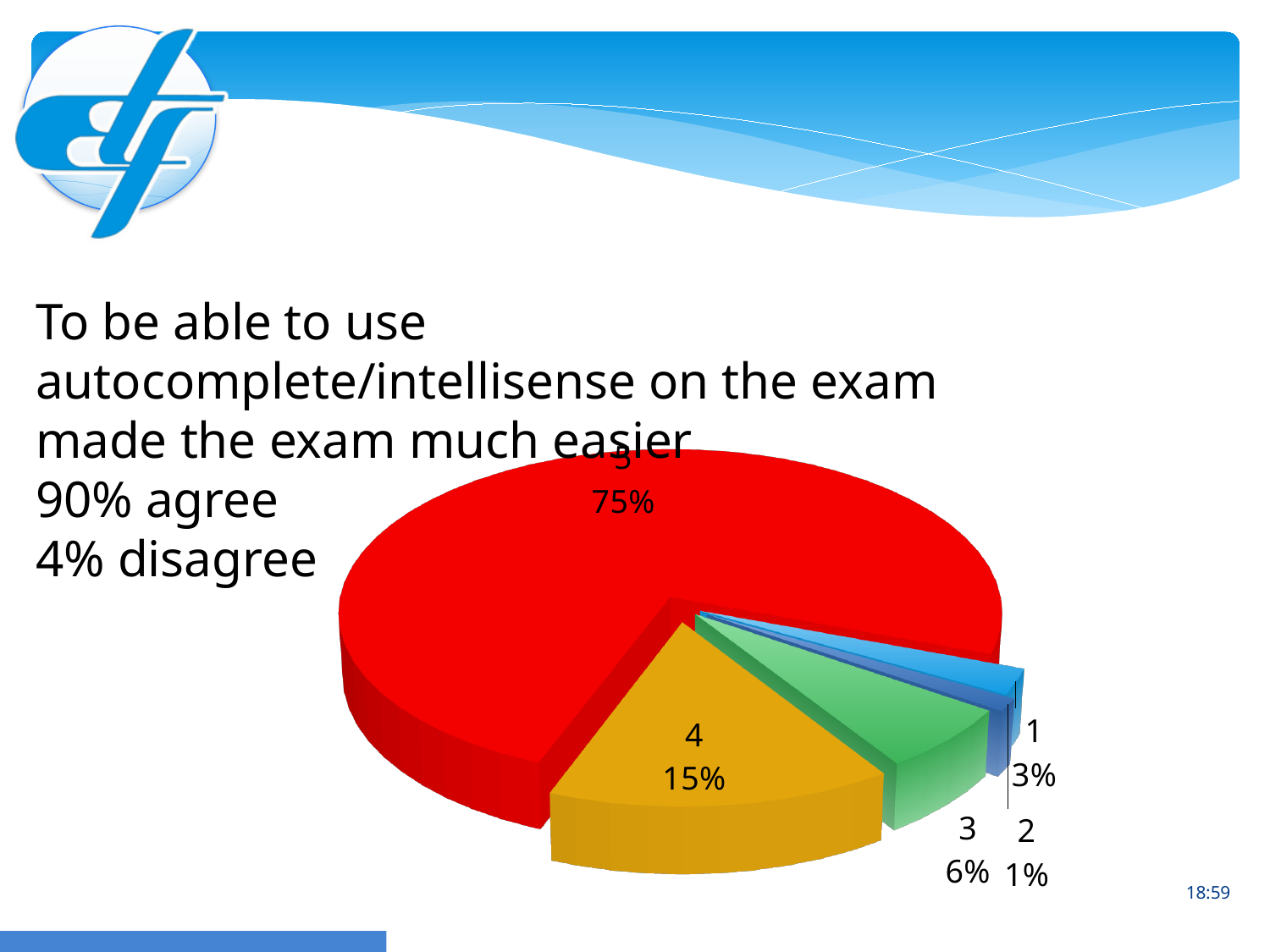
What percentage is shown for category 4 in the pie chart? 15% What percentage is shown for category 3 in the pie chart? 6% Which category has the smallest slice of the pie chart? 2 Which has a larger share, category 3 or category 1? 3 What percentage is shown for category 1 in the pie chart? 3% What percentage is shown for category 2 in the pie chart? 1% What colour is the slice for category 4? yellow Which category has the largest slice of the pie chart? 5 What percentage is shown for category 5 in the pie chart? 75% What type of chart is shown on the slide? pie chart How many slices does the pie chart have? 5 What is the difference in percentage points between category 5 and category 4? 60